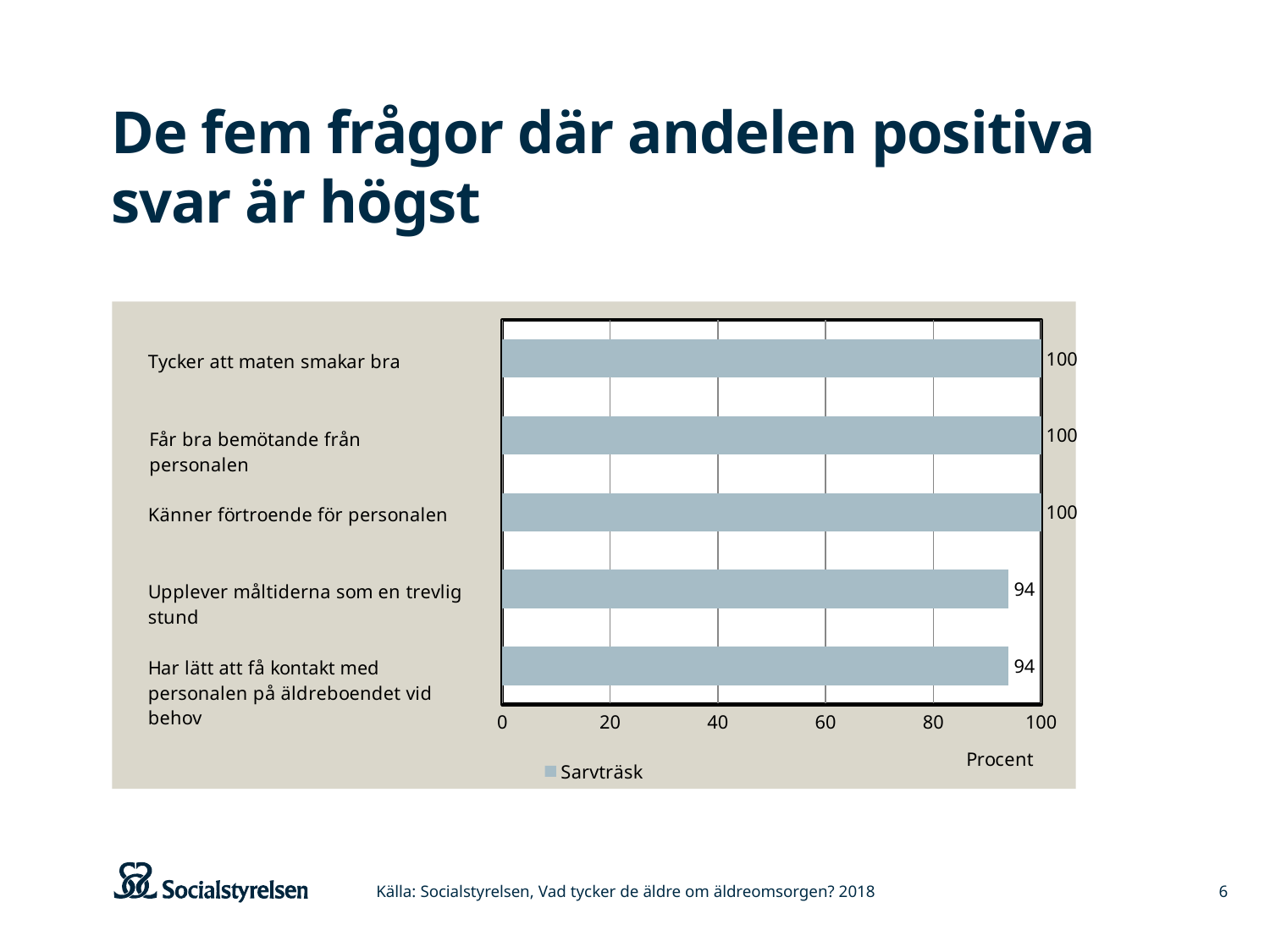
What kind of chart is shown on the slide? bar chart What is the value for "Upplever måltiderna som en trevlig stund"? 94 What is the difference between the value for "Tycker att maten smakar bra" and the value for "Har lätt att få kontakt med personalen på äldreboendet vid behov"? 6 What is the value for "Har lätt att få kontakt med personalen på äldreboendet vid behov"? 94 What is the value for "Får bra bemötande från personalen"? 100 How many categories are shown in the chart? 5 What is the value for "Tycker att maten smakar bra"? 100 What is the name of the series shown in the legend? Sarvträsk What is the value for "Känner förtroende för personalen"? 100 Is the value for "Upplever måltiderna som en trevlig stund" greater or less than 80? greater Which has the larger value, "Känner förtroende för personalen" or "Upplever måltiderna som en trevlig stund"? Känner förtroende för personalen How many series does the legend list? 1